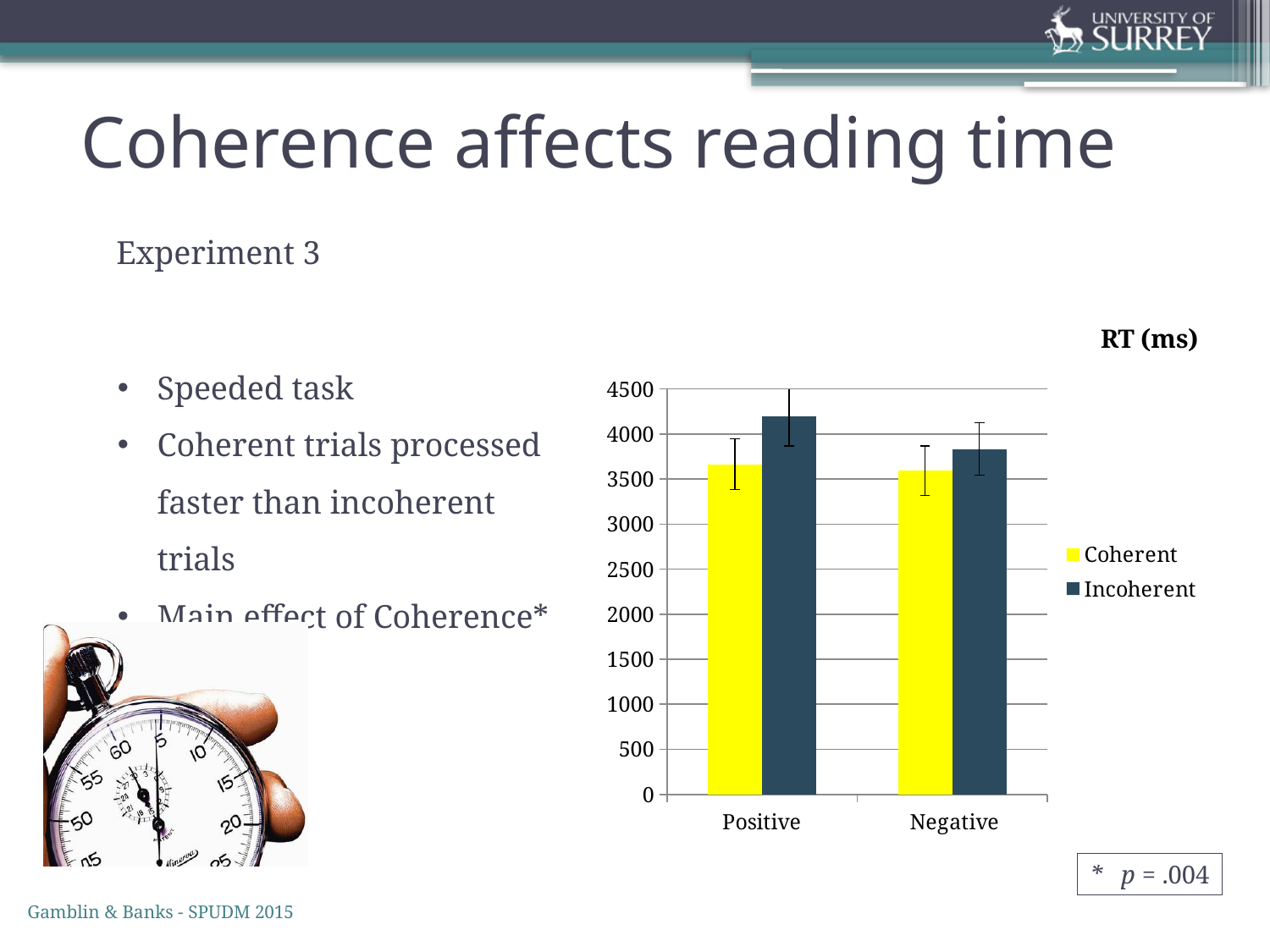
For the Negative category, which is larger: the Coherent or the Incoherent value? Incoherent Is the Coherent value for Negative greater or less than 3000? greater How many series does the chart's legend list? 2 For the Positive category, which is larger: the Coherent or the Incoherent value? Incoherent Which colour represents the Coherent series in the chart? yellow Which bar in the chart is the highest? Incoherent, Positive Is the Incoherent value for Negative greater or less than 4000? less How many categories are shown on the x axis of the chart? 2 Is the Incoherent value for Positive greater or less than 4000? greater What label is given for the y axis of the chart? RT (ms) What kind of chart is shown on the slide? bar chart